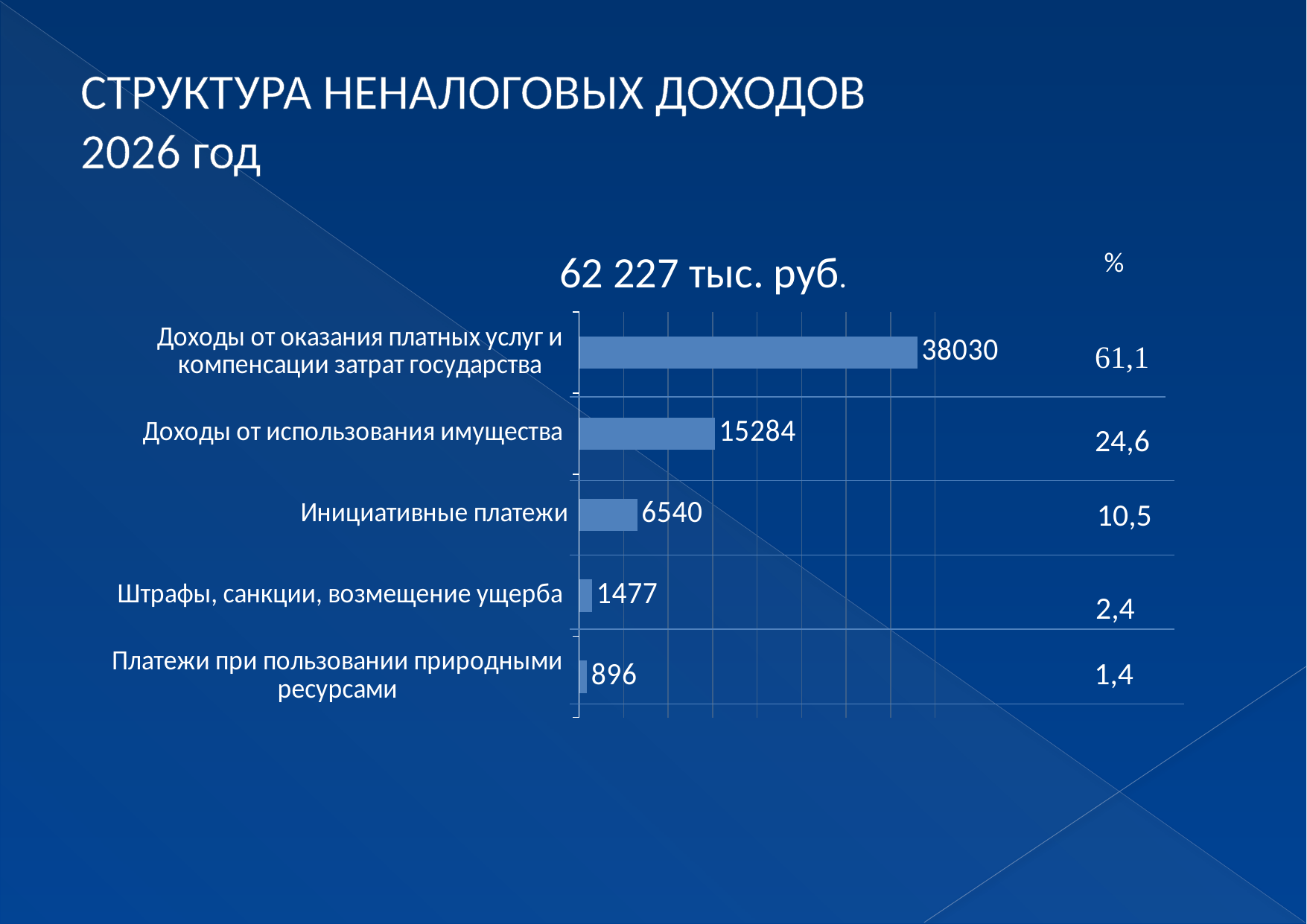
Which category has the lowest value? Платежи при пользовании природными ресурсами What is the value for «Инициативные платежи»? 6540 What percentage share is shown next to «Доходы от оказания платных услуг и компенсации затрат государства»? 61,1 What is the value for «Штрафы, санкции, возмещение ущерба»? 1477 What type of chart is shown on the slide? bar chart What total amount is shown in the chart title above the bars? 62 227 тыс. руб. What is the difference between the values for «Доходы от оказания платных услуг и компенсации затрат государства» and «Доходы от использования имущества»? 22746 Which category has the highest value? Доходы от оказания платных услуг и компенсации затрат государства What is the value for «Доходы от использования имущества»? 15284 How many categories does the bar chart show? 5 What is the value for «Платежи при пользовании природными ресурсами»? 896 Which is larger: the value for «Инициативные платежи» or for «Штрафы, санкции, возмещение ущерба»? Инициативные платежи